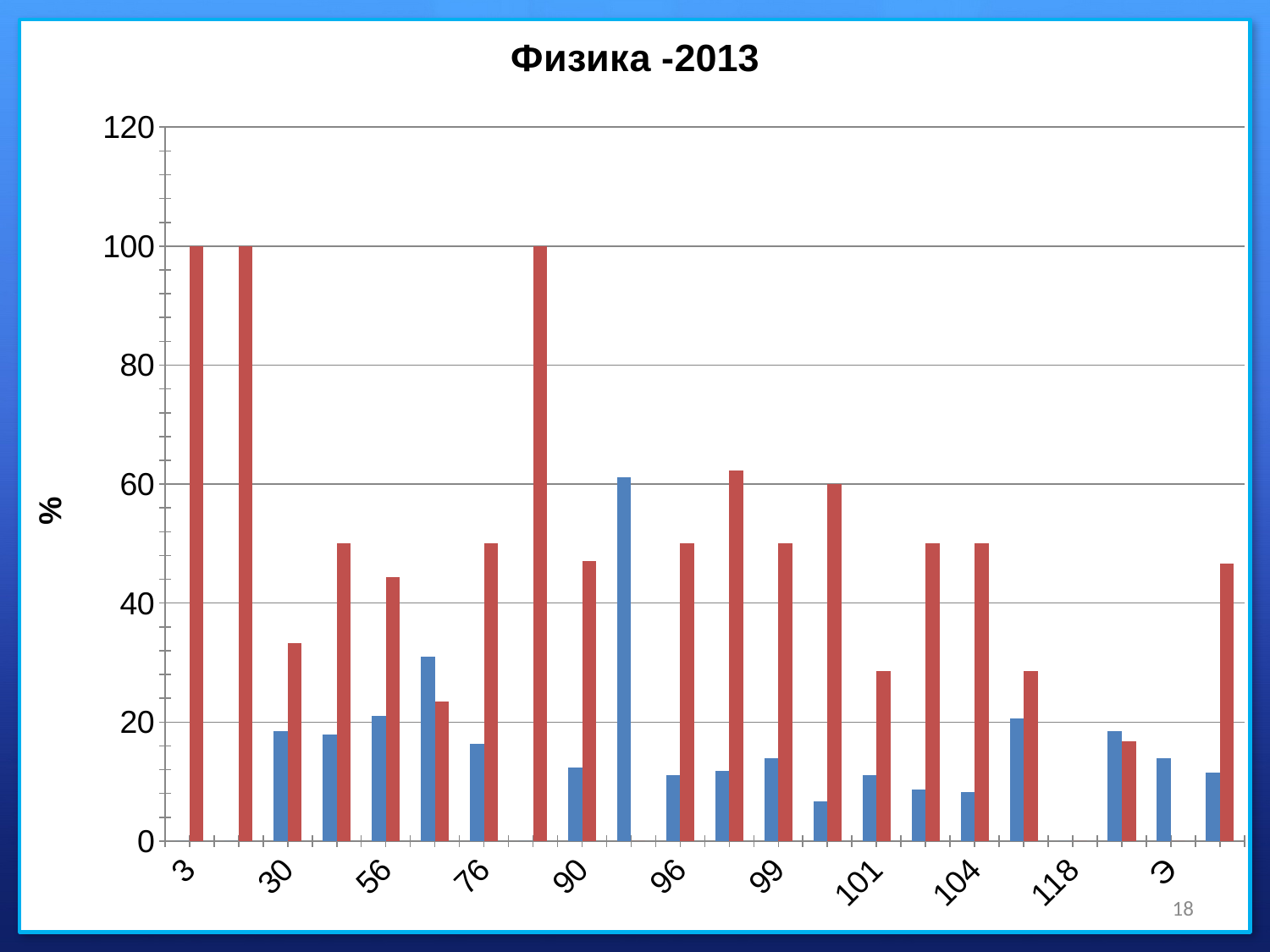
Is the value of the blue bar for category 96 greater or less than 20? less Is the value of the blue bar for category Э greater or less than 20? less Is the value of the blue bar for category 30 greater or less than 40? less What is the label on the vertical axis of the chart? % What is the title of the chart? Физика -2013 For category 56, which bar is taller, the red bar or the blue bar? the red bar What is the value of the red bar for category 3? 100 What kind of chart is shown on the slide? bar chart For category 30, which bar is taller, the red bar or the blue bar? the red bar